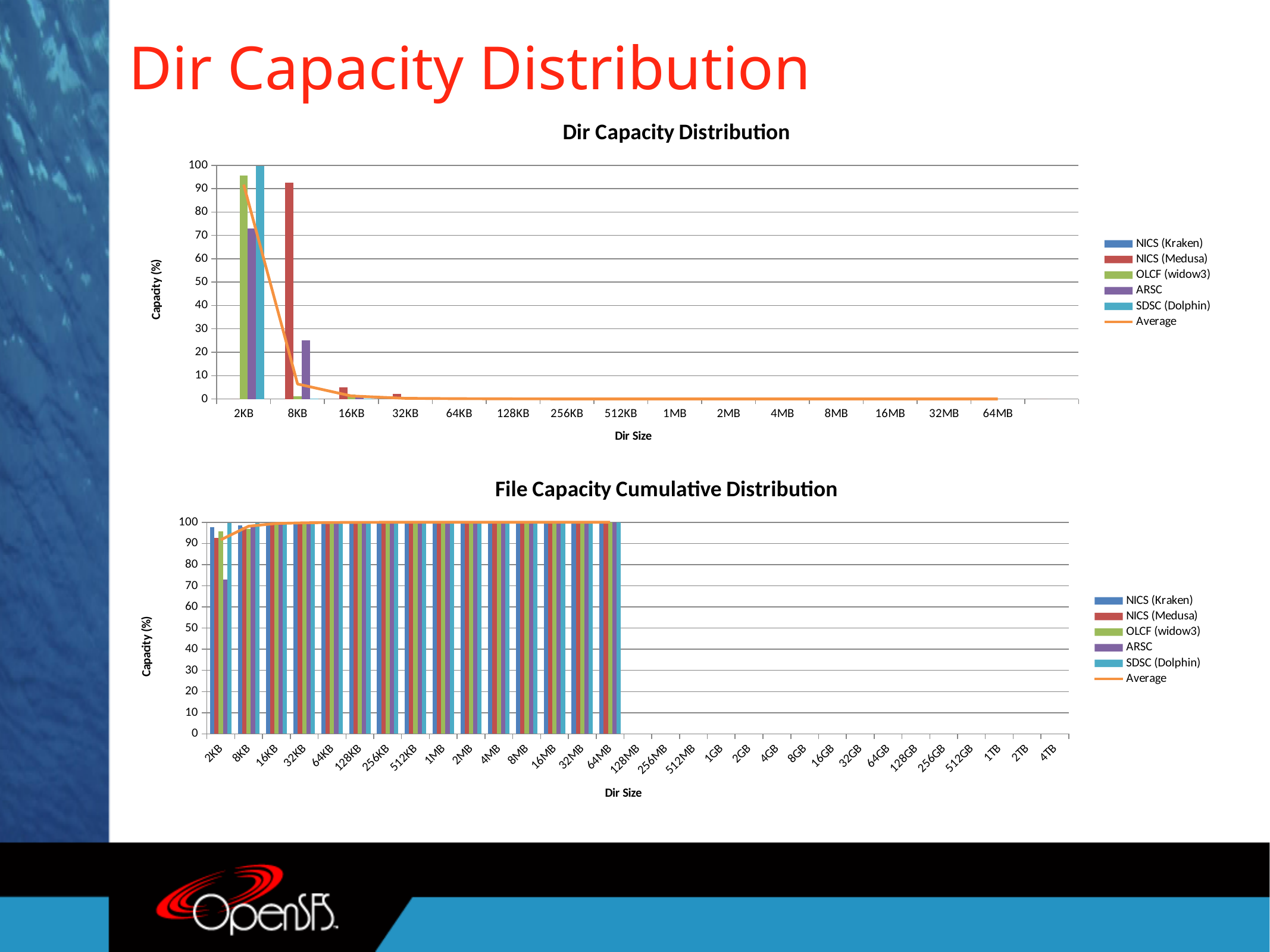
In the top chart, Dir Capacity Distribution, how many series does the legend list? 6 In the bottom chart, File Capacity Cumulative Distribution, does the Average line rise or fall from 2KB to 64MB? rise In the top chart, Dir Capacity Distribution, does the Average line rise or fall as Dir Size increases? fall In the top chart, Dir Capacity Distribution, is the value for ARSC at 8KB greater or less than 40? less What kind of chart is the top chart, Dir Capacity Distribution? bar chart with a line series In the top chart, Dir Capacity Distribution, which is larger at 2KB: SDSC (Dolphin) or ARSC? SDSC (Dolphin) In the top chart, Dir Capacity Distribution, which series has the highest bar at 8KB? NICS (Medusa) In the top chart, Dir Capacity Distribution, is the value for NICS (Medusa) at 8KB greater or less than 80? greater What is the y-axis title of the bottom chart, File Capacity Cumulative Distribution? Capacity (%) In the top chart, Dir Capacity Distribution, is the value for ARSC at 2KB greater or less than 60? greater In the top chart, Dir Capacity Distribution, how many categories are shown on the x axis? 15 In the bottom chart, File Capacity Cumulative Distribution, how many categories are shown on the x axis? 31